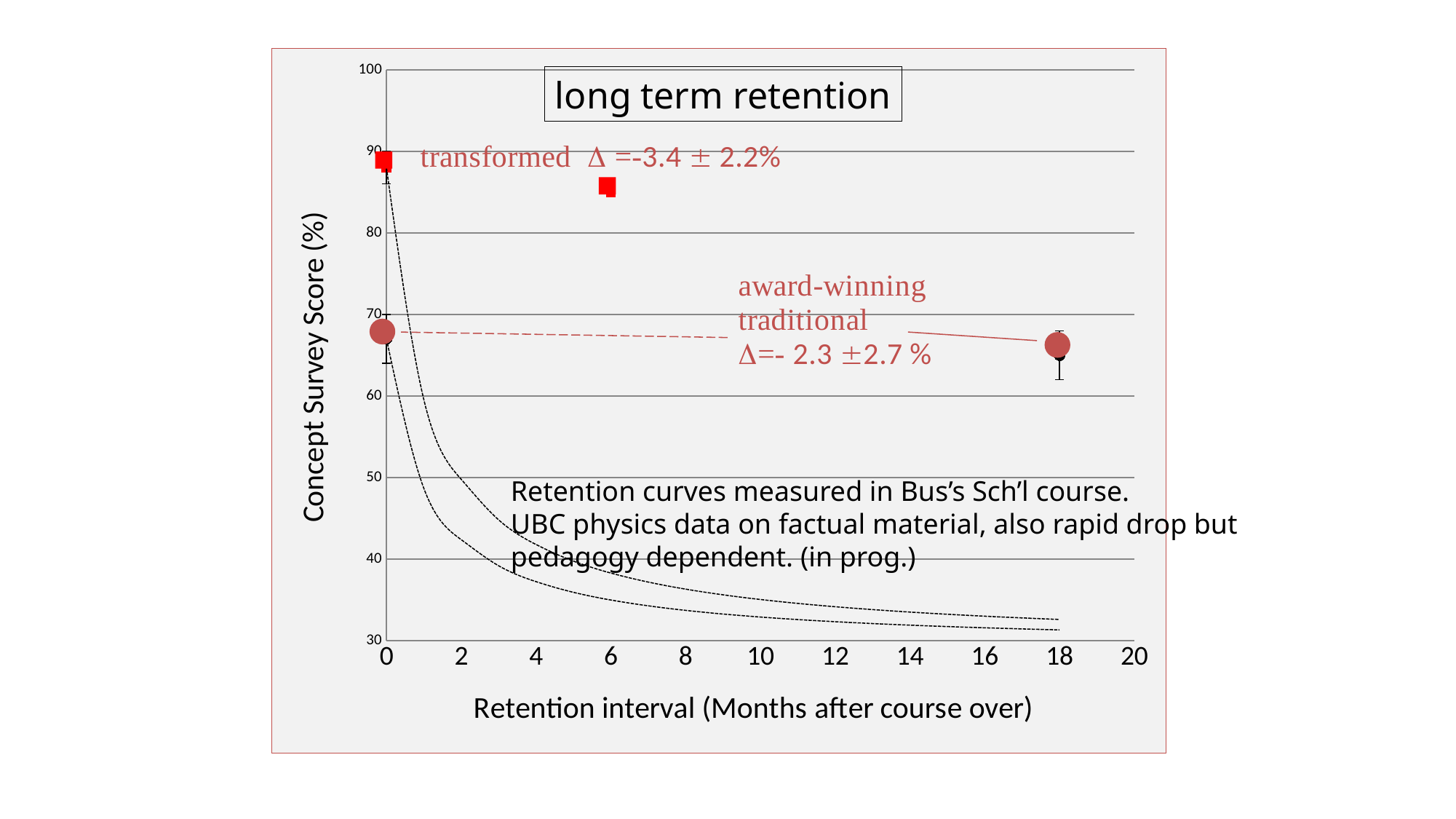
Is the transformed series' score at 6 months greater or less than 80? greater What is the title of the chart? long term retention What is the label of the y axis? Concept Survey Score (%) How many data points are plotted for the transformed series? 2 At 0 months, which series has the higher concept survey score, transformed or award-winning traditional? transformed What change (Δ) is annotated for the transformed series? -3.4 ± 2.2% Is the award-winning traditional series' score at 0 months greater or less than 80? less Is the transformed series' score at 0 months greater or less than 80? greater Do the dashed retention curves rise or fall as the retention interval increases? fall What change (Δ) is annotated for the award-winning traditional series? -2.3 ± 2.7 % What kind of chart is shown on the slide? scatter chart